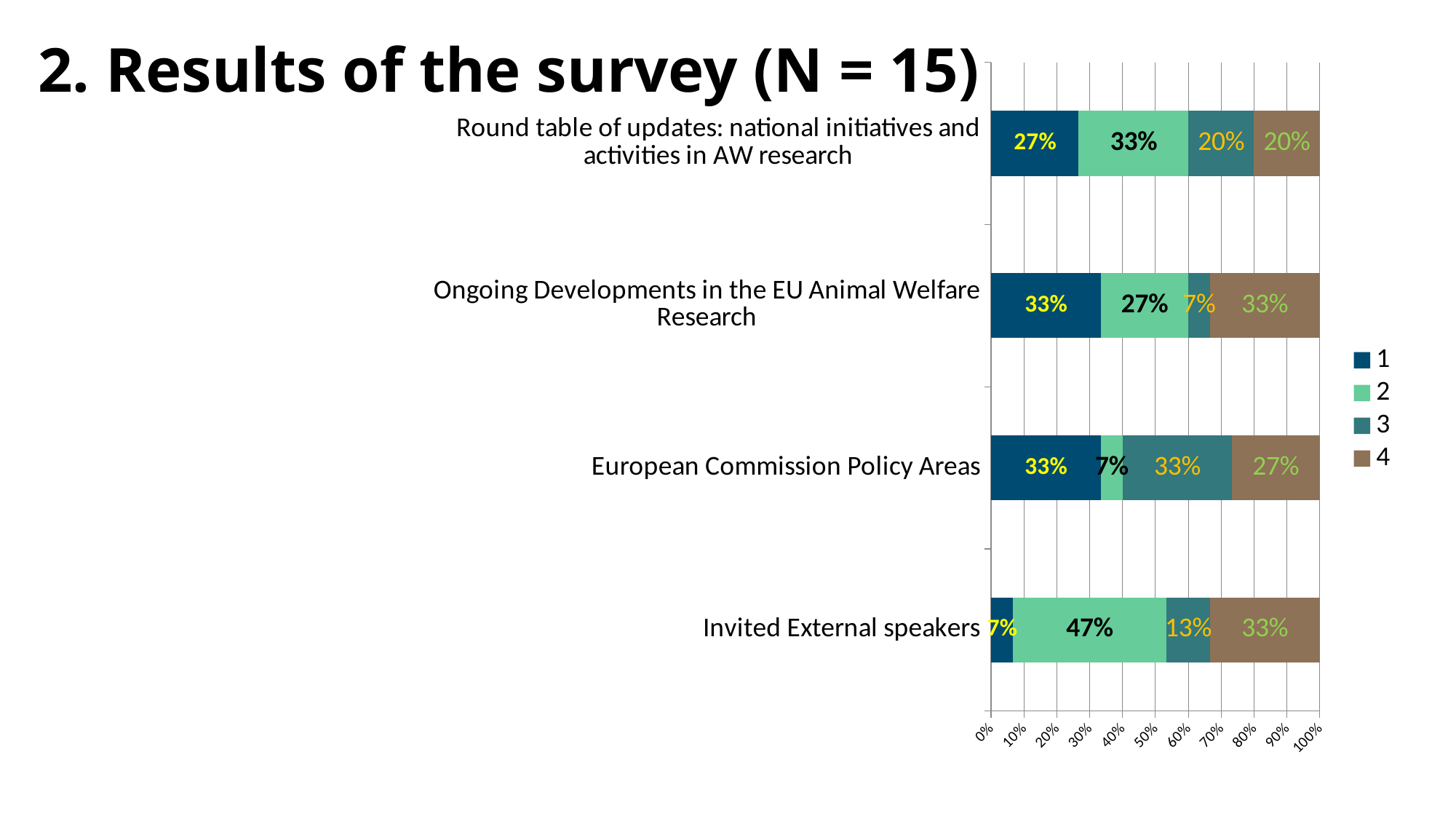
What is the value of series 3 for "Ongoing Developments in the EU Animal Welfare Research"? 7% Which category has the highest value for series 2? Invited External speakers How many categories are plotted in the chart? 4 For "Round table of updates: national initiatives and activities in AW research", which is larger: the value for series 1 or the value for series 3? Series 1 What is the value of series 4 for "European Commission Policy Areas"? 27% Which category has the lowest value for series 1? Invited External speakers What are the legend entries of the chart? 1, 2, 3, 4 What is the value of series 2 for "Invited External speakers"? 47% What is the difference between the series 2 value for "Invited External speakers" and the series 2 value for "European Commission Policy Areas"? 40% What kind of chart is shown on the slide? Stacked bar chart How many series does the legend list? 4 What is the value of series 1 for "Round table of updates: national initiatives and activities in AW research"? 27%